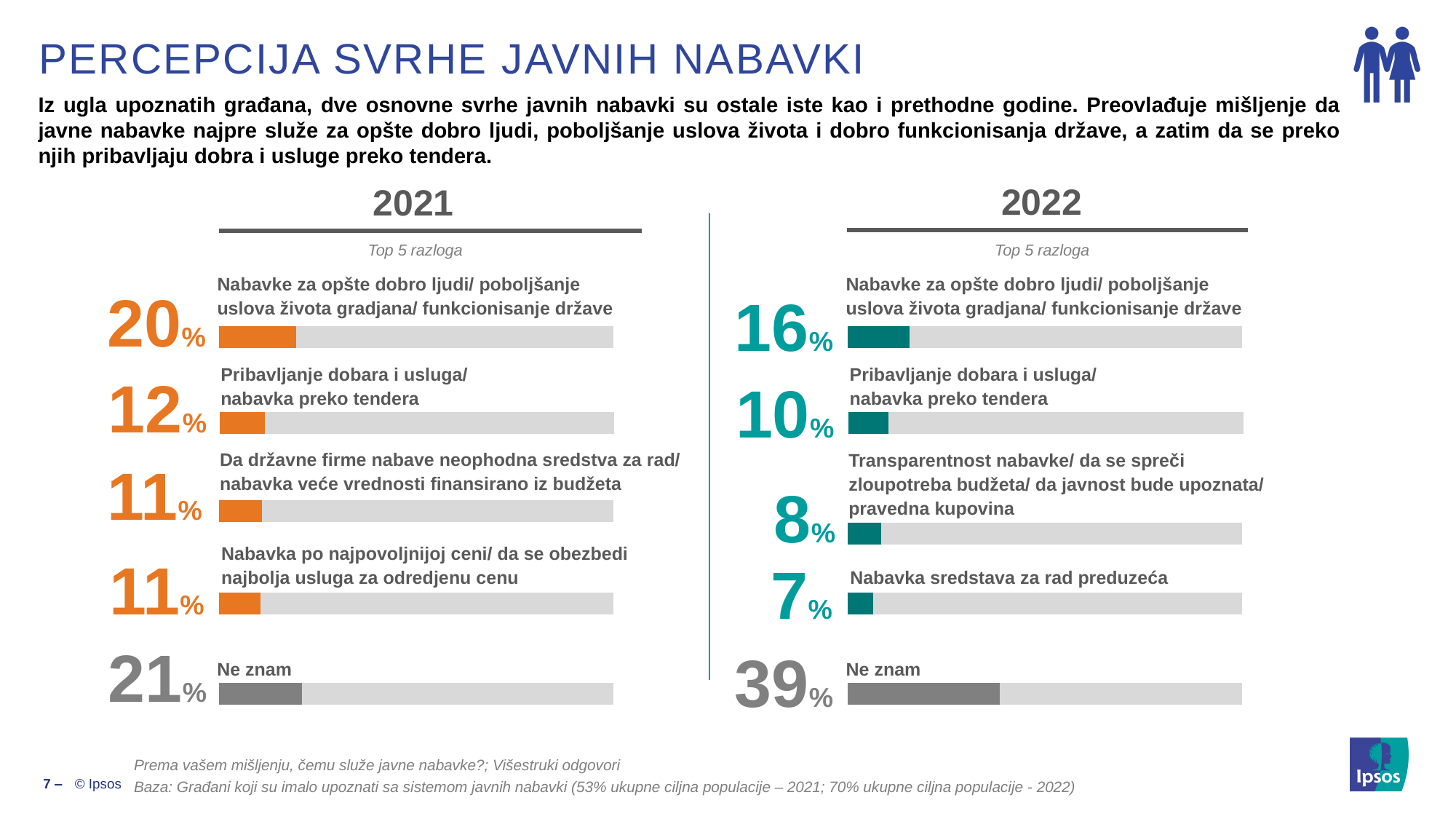
In the 2022 chart, what is the value for "Nabavke za opšte dobro ljudi/ poboljšanje uslova života gradjana/ funkcionisanje države"? 16% In the 2021 chart, what is the value for "Pribavljanje dobara i usluga/ nabavka preko tendera"? 12% What colour are the bars for the Top 5 reasons in the 2022 chart? Teal What is the difference between the "Ne znam" values in the 2022 chart and the 2021 chart? 18% How many categories are shown in the 2022 chart? 5 In the 2021 chart, which category has the highest value? Ne znam In the 2022 chart, what is the difference between "Pribavljanje dobara i usluga/ nabavka preko tendera" and "Transparentnost nabavke/ da se spreči zloupotreba budžeta/ da javnost bude upoznata/ pravedna kupovina"? 2% In the 2022 chart, what is the value for "Ne znam"? 39% What kind of chart is used in the 2021 section? Bar chart Which is larger: the value for "Nabavke za opšte dobro ljudi/ poboljšanje uslova života gradjana/ funkcionisanje države" in the 2021 chart or in the 2022 chart? 2021 In the 2022 chart, what is the value for "Nabavka sredstava za rad preduzeća"? 7% In the 2022 chart, which of the Top 5 reasons has the lowest value? Nabavka sredstava za rad preduzeća